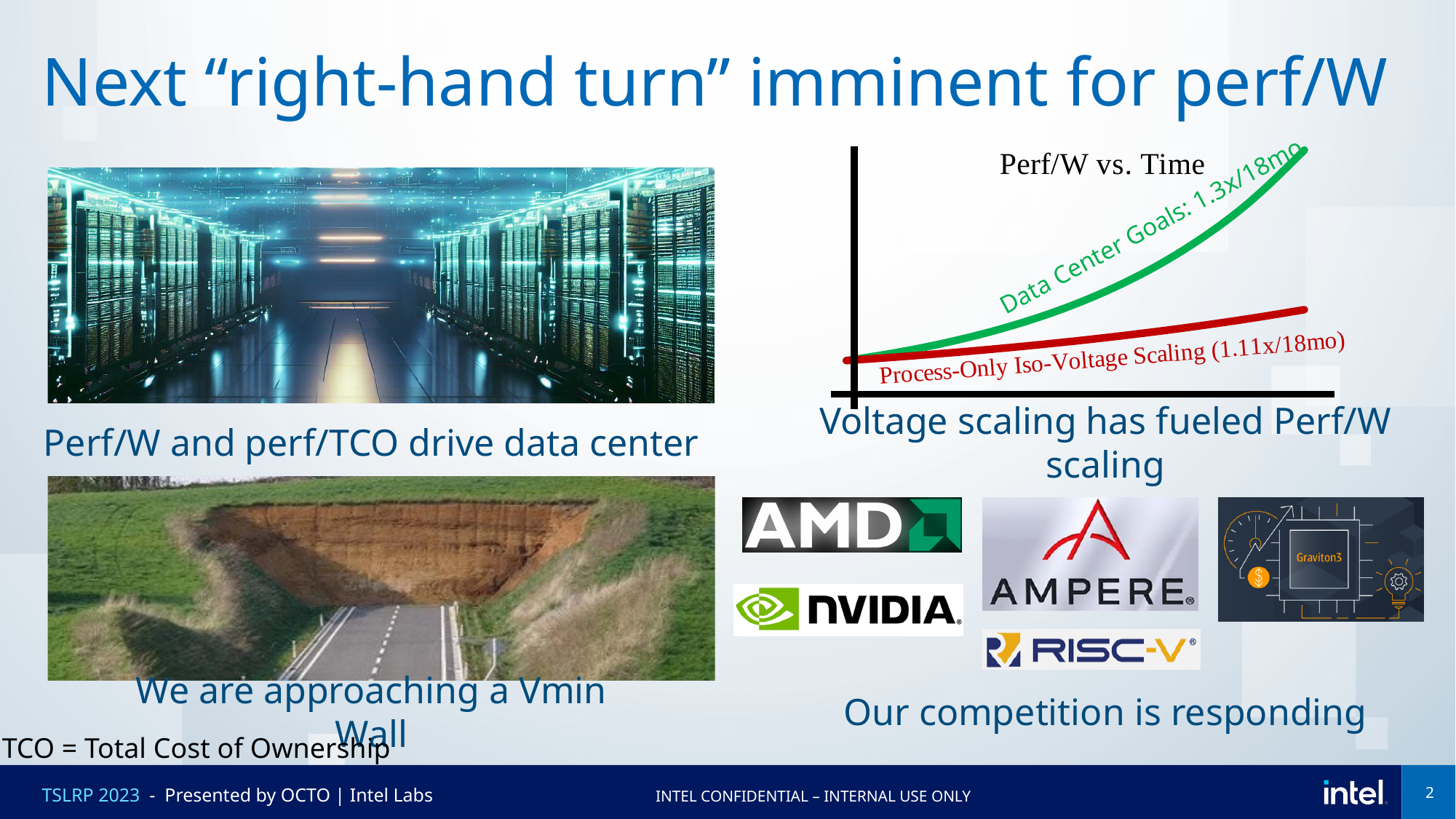
On the "Perf/W vs. Time" chart, does the Process-Only Iso-Voltage Scaling line rise or fall over time? rise On the "Perf/W vs. Time" chart, what growth rate is labeled for Data Center Goals? 1.3x/18mo What is the title of the chart on the right side of the slide? Perf/W vs. Time How many lines are plotted on the "Perf/W vs. Time" chart? 2 On the "Perf/W vs. Time" chart, which line has the steeper growth rate? Data Center Goals On the "Perf/W vs. Time" chart, does the Data Center Goals line rise or fall over time? rise What kind of chart is the "Perf/W vs. Time" chart? line chart On the "Perf/W vs. Time" chart, which line is higher at the right end: Data Center Goals or Process-Only Iso-Voltage Scaling? Data Center Goals On the "Perf/W vs. Time" chart, what colour is the Data Center Goals line? green On the "Perf/W vs. Time" chart, what growth rate is labeled for Process-Only Iso-Voltage Scaling? 1.11x/18mo